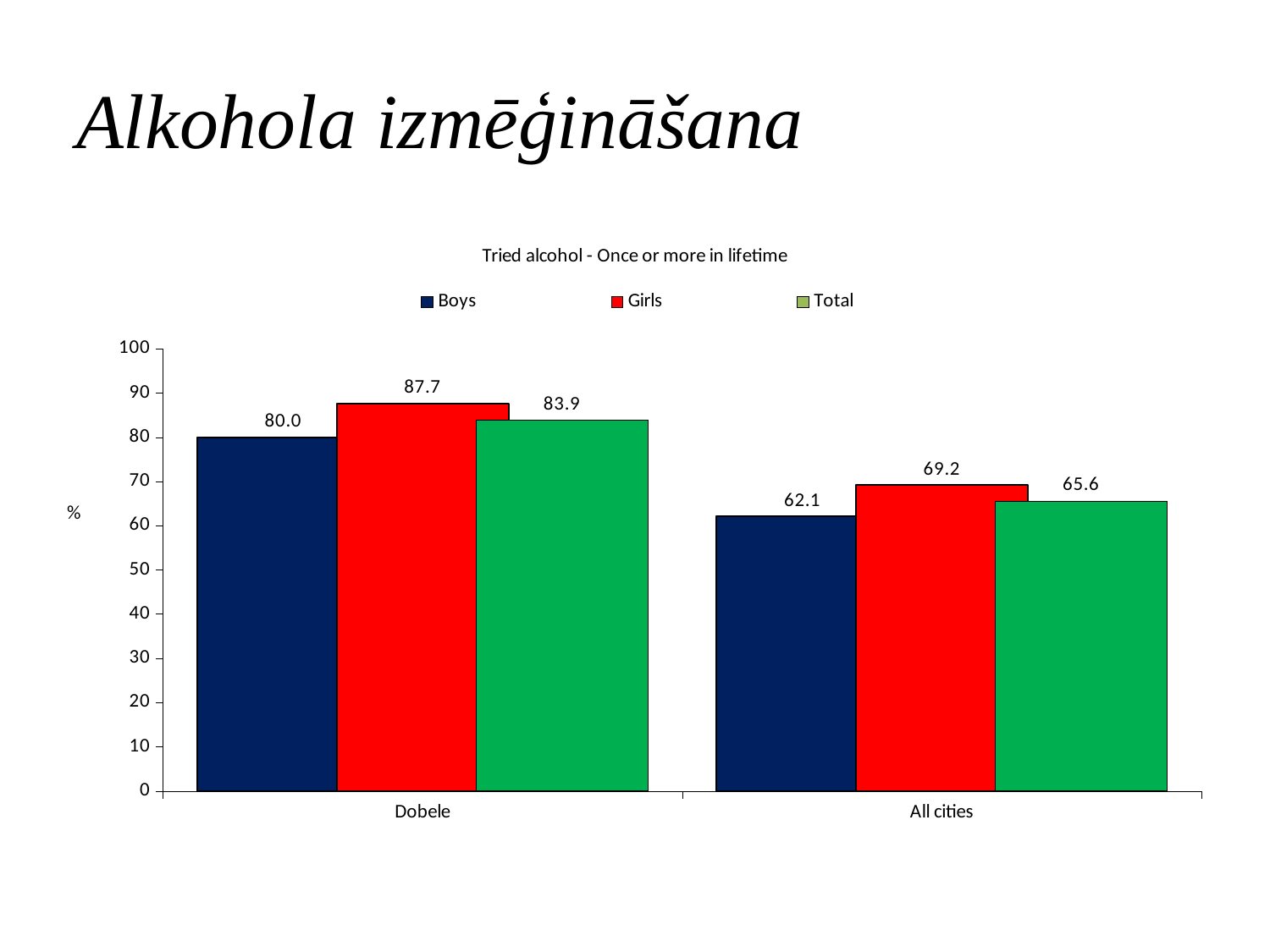
Is the value for Total in All cities greater or less than 70? less How many categories are shown on the x axis? 2 Which series has the lowest value in Dobele? Boys What is the difference between the Girls value and the Boys value in Dobele? 7.7 Which is larger: the Boys value in Dobele or the Girls value in All cities? Boys value in Dobele What kind of chart is shown on the slide? bar chart Which series has the highest value in All cities? Girls How many series does the legend list? 3 What is the value for Boys in All cities? 62.1 What is the difference between the Total value for Dobele and the Total value for All cities? 18.3 What is the value for Girls in Dobele? 87.7 What is the Total value for Dobele? 83.9